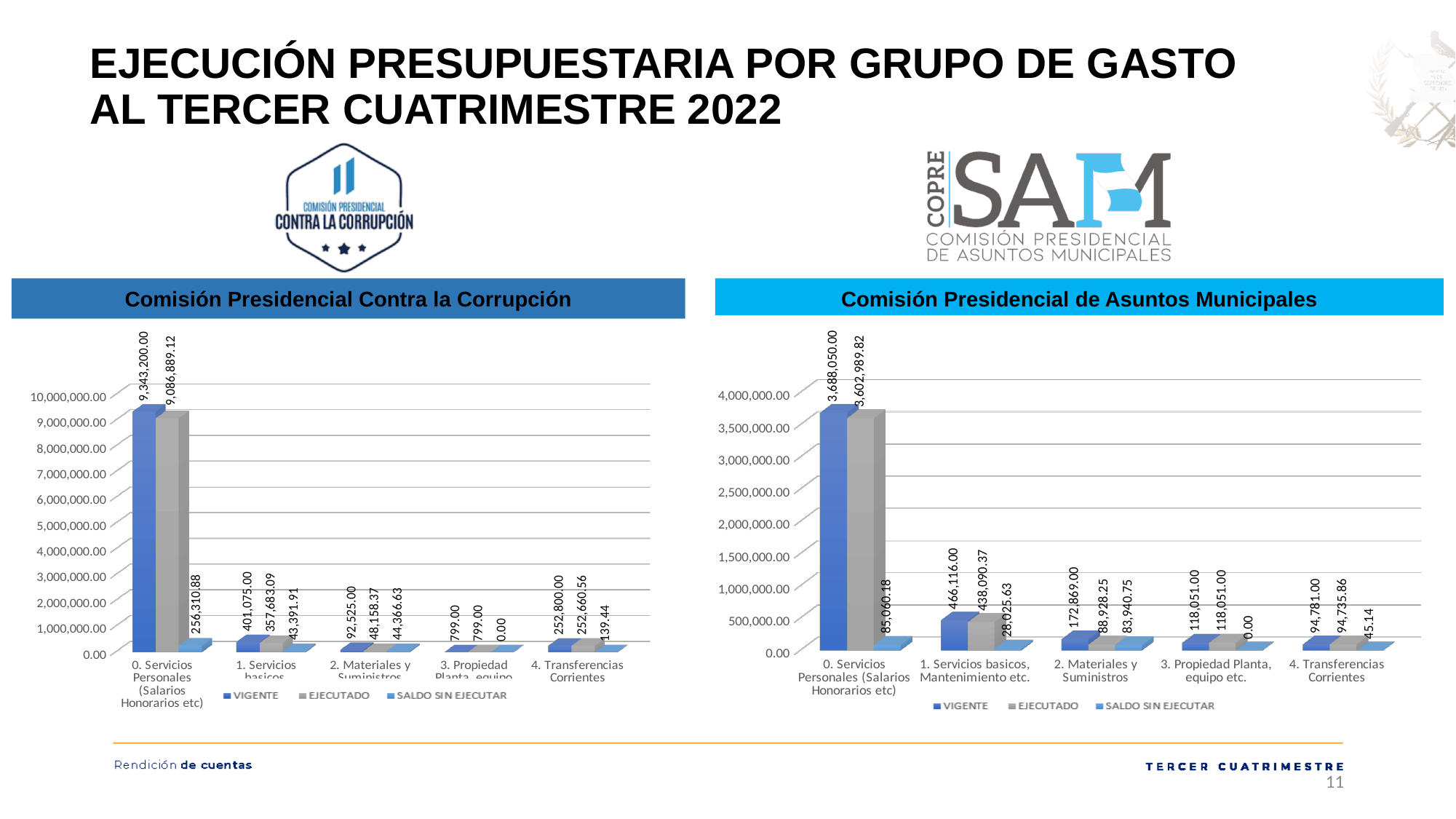
In the Comisión Presidencial de Asuntos Municipales chart, which is larger for 2. Materiales y Suministros: EJECUTADO or SALDO SIN EJECUTAR? EJECUTADO In the Comisión Presidencial Contra la Corrupción chart, what is the SALDO SIN EJECUTAR value for 2. Materiales y Suministros? 44,366.63 In the Comisión Presidencial de Asuntos Municipales chart, which category has the lowest VIGENTE value? 4. Transferencias Corrientes What type of chart is the Comisión Presidencial Contra la Corrupción chart? Bar chart In the Comisión Presidencial de Asuntos Municipales chart, is the VIGENTE value for 0. Servicios Personales greater or less than 3,500,000.00? greater How many categories are shown on the x axis of the Comisión Presidencial de Asuntos Municipales chart? 5 In the Comisión Presidencial Contra la Corrupción chart, what is the VIGENTE value for 0. Servicios Personales? 9,343,200.00 In the Comisión Presidencial de Asuntos Municipales chart, what is the EJECUTADO value for 1. Servicios basicos, Mantenimiento etc.? 438,090.37 In the Comisión Presidencial Contra la Corrupción chart, which category has the highest EJECUTADO value? 0. Servicios Personales In the Comisión Presidencial Contra la Corrupción chart, how many series does the legend list? 3 In the Comisión Presidencial Contra la Corrupción chart, what is the difference between VIGENTE and EJECUTADO for 4. Transferencias Corrientes? 139.44 In the Comisión Presidencial de Asuntos Municipales chart, what is the SALDO SIN EJECUTAR value for 3. Propiedad Planta, equipo etc.? 0.00